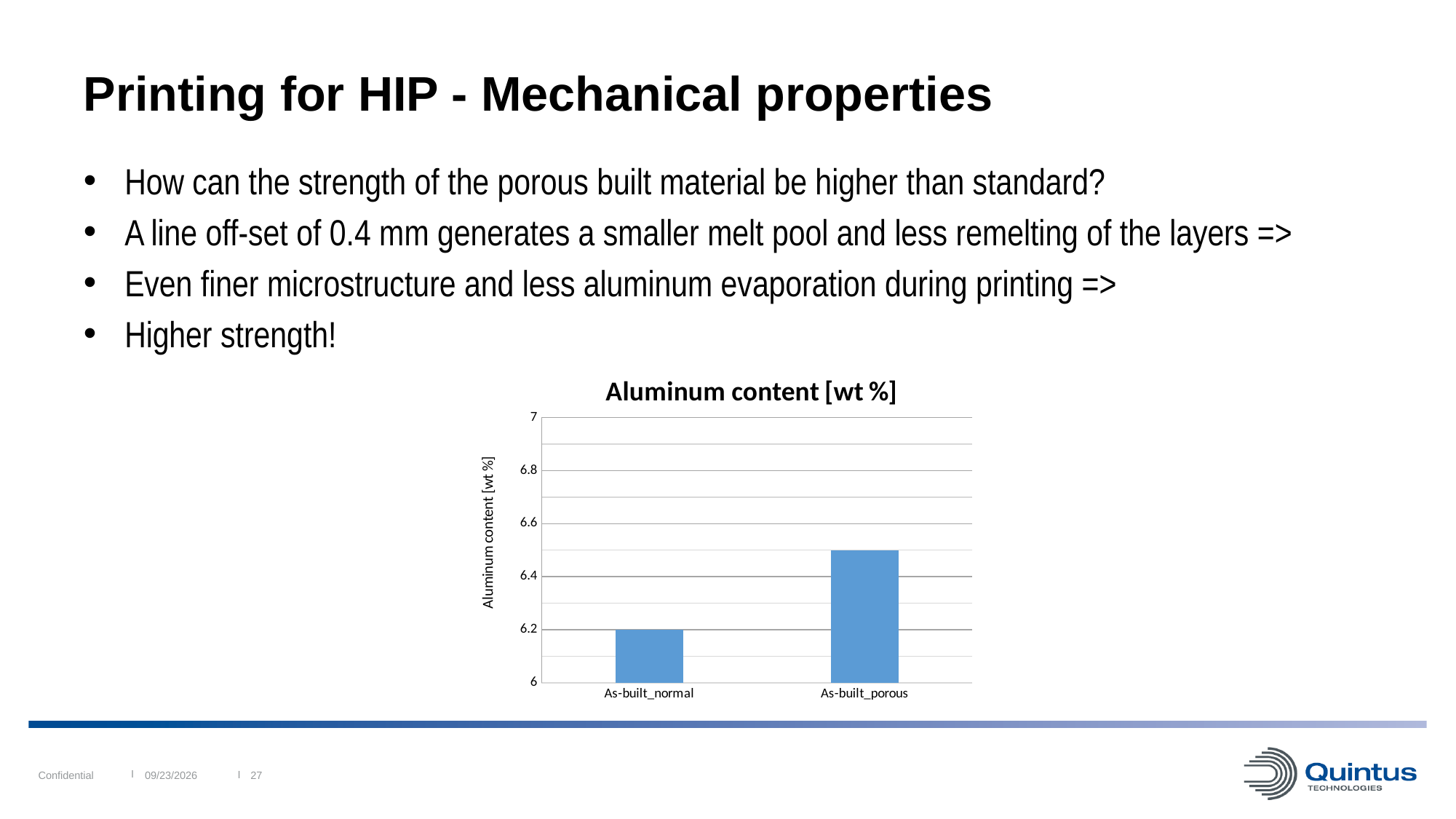
What is the label of the vertical axis of the chart? Aluminum content [wt %] Is the value for As-built_porous greater or less than 6.6? less What is the title of the chart? Aluminum content [wt %] Which category has the highest aluminum content? As-built_porous Is the value for As-built_porous greater or less than 6.4? greater Is the value for As-built_normal greater or less than 6.4? less What type of chart is shown on the slide? bar chart Do the values rise or fall from As-built_normal to As-built_porous? rise Which category has the lowest aluminum content? As-built_normal How many categories are plotted in the chart? 2 What is the aluminum content value for As-built_normal? 6.2 Which has a larger aluminum content, As-built_normal or As-built_porous? As-built_porous